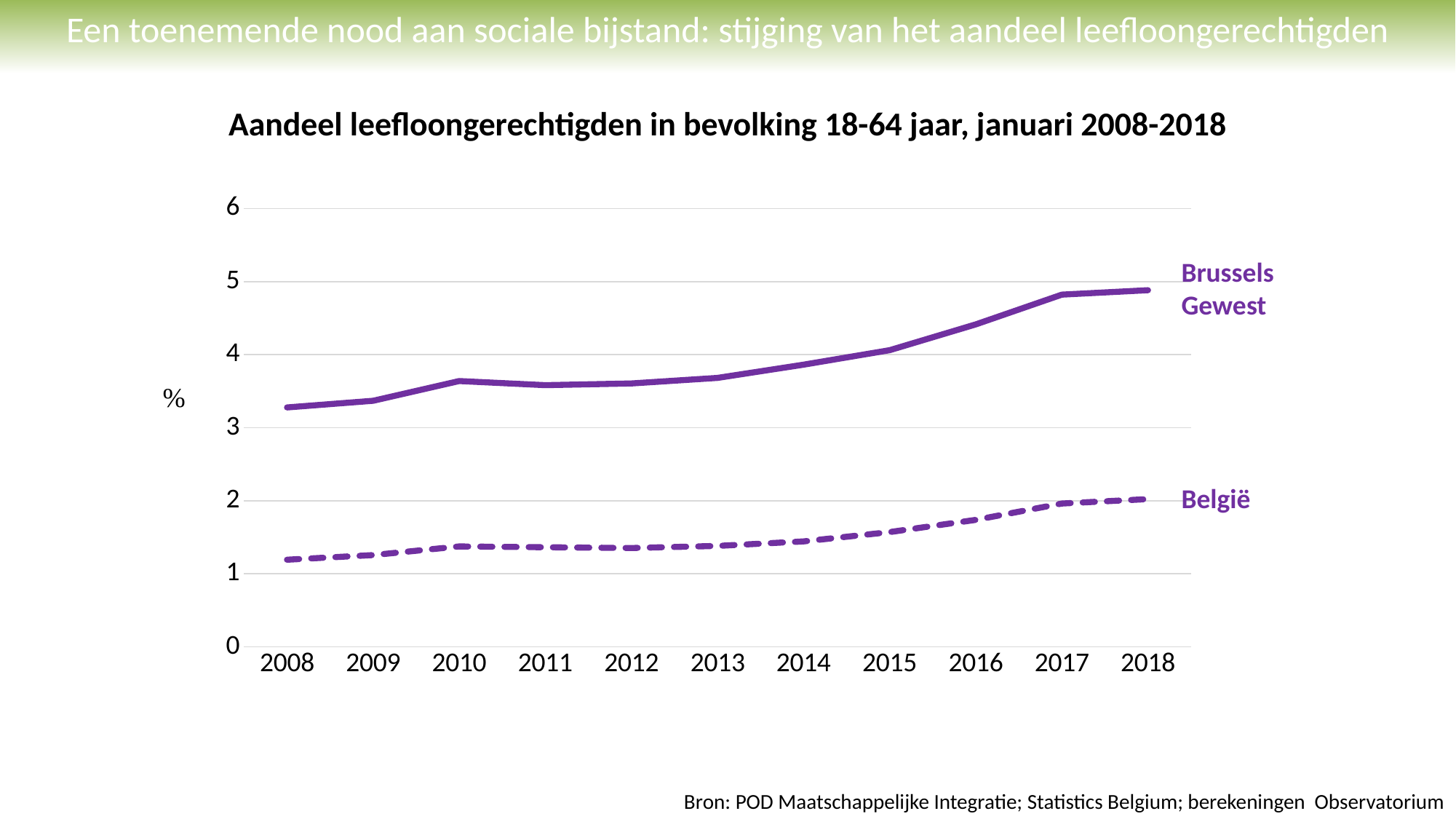
Which series has the higher value in 2018, Brussels Gewest or België? Brussels Gewest Is the value for Brussels Gewest in 2018 greater or less than 5? less Does the value for België rise or fall between 2008 and 2018? rise Does the value for Brussels Gewest rise or fall between 2008 and 2018? rise How many years are shown on the x axis of the chart? 11 What kind of chart is shown on the slide? line chart Is the value for Brussels Gewest in 2008 greater or less than 3? greater Is the value for België in 2008 greater or less than 1? greater How many series are plotted in the chart? 2 In which year is the value for Brussels Gewest highest? 2018 What is the title of the chart? Aandeel leefloongerechtigden in bevolking 18-64 jaar, januari 2008-2018